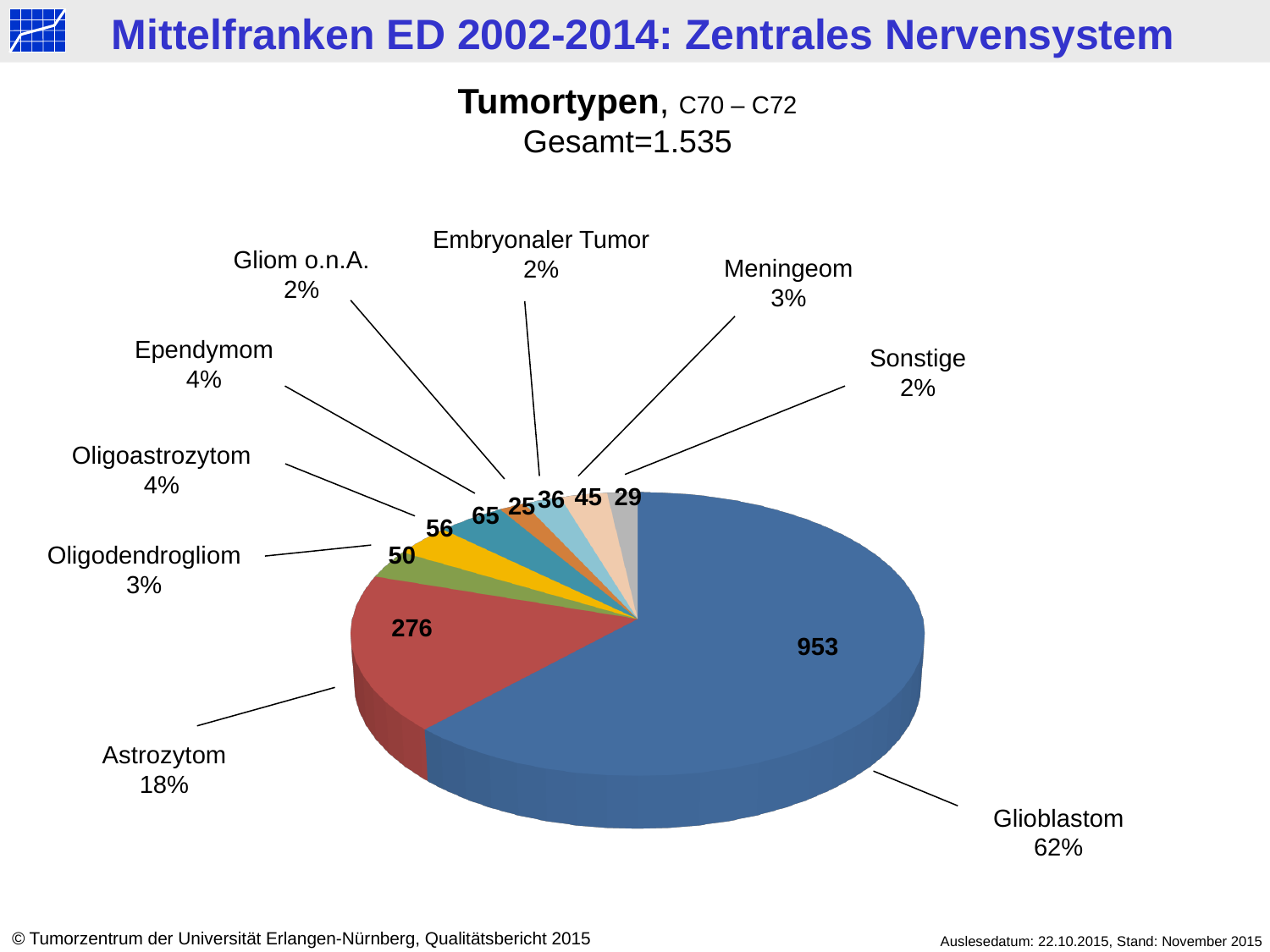
Which tumour type has the largest slice of the pie? Glioblastom How many tumour types (slices) does the pie chart show? 9 What is the value shown for Glioblastom? 953 What is the difference between the values for Glioblastom and Astrozytom? 677 Which tumour type has the smallest value in the pie chart? Gliom o.n.A. What is the value shown for Meningeom? 45 What kind of chart is shown on the slide? pie chart What is the value shown for Ependymom? 65 Which has the larger value, Ependymom or Oligoastrozytom? Ependymom What is the value shown for Astrozytom? 276 What total (Gesamt) is stated in the chart title? 1.535 What share of the pie does Astrozytom account for? 18%